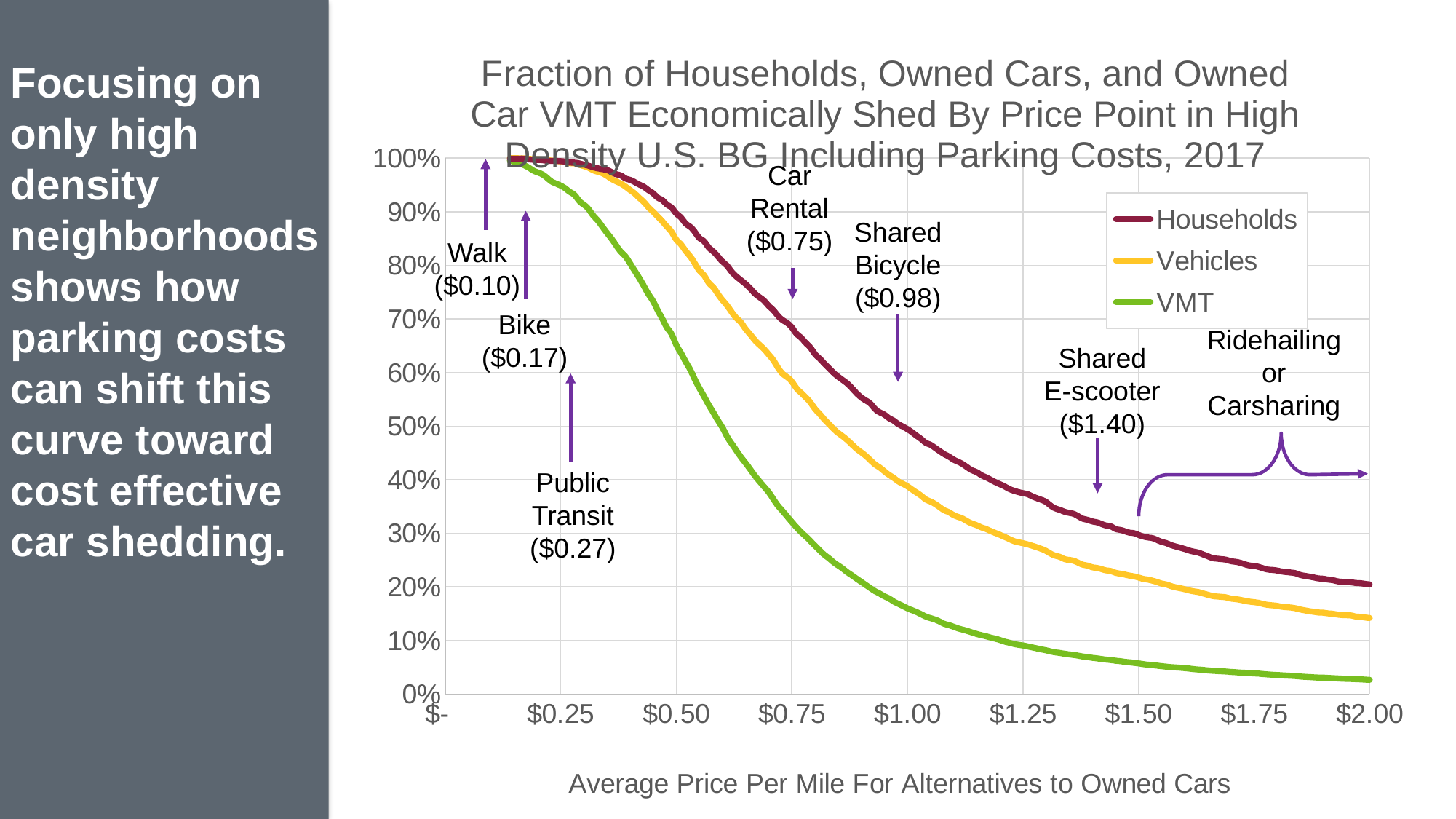
What kind of chart is shown on the slide? line chart What price per mile is annotated for Public Transit on the chart? $0.27 Which series has the lowest value at $2.00? VMT Is the VMT value at $2.00 greater or less than 10%? less Is the Vehicles value at $2.00 greater or less than 20%? less What is the x-axis title of the chart? Average Price Per Mile For Alternatives to Owned Cars Do the values of the Households series rise or fall as the price per mile increases along the x axis? fall At $1.00, which is larger, the Households value or the VMT value? Households Is the Vehicles value at $0.50 greater or less than 80%? greater Which series has the highest value at $1.50? Households How many series does the legend list? 3